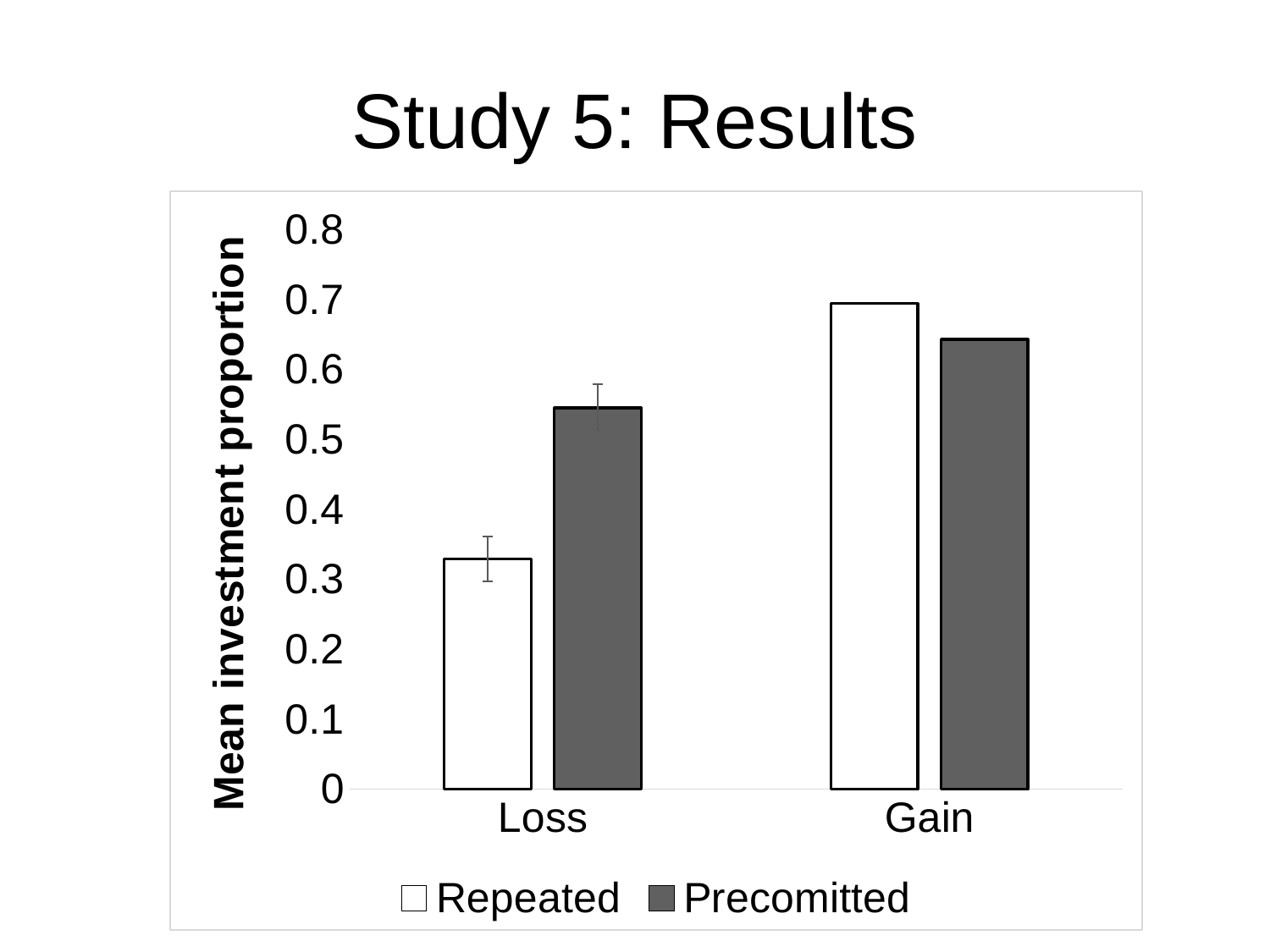
Is the Repeated value for Loss greater or less than 0.4? less What kind of chart is shown on the slide? Bar chart What is the title of the y axis? Mean investment proportion How many categories are shown on the x axis? 2 For the Gain condition, which series has the larger value, Repeated or Precomitted? Repeated Which bar is the tallest in the chart? Repeated for Gain Is the Precomitted value for Loss greater or less than 0.5? greater Which bar is the shortest in the chart? Repeated for Loss For the Loss condition, which series has the larger value, Repeated or Precomitted? Precomitted Is the Repeated value for Gain greater or less than 0.6? greater How many series does the legend list? 2